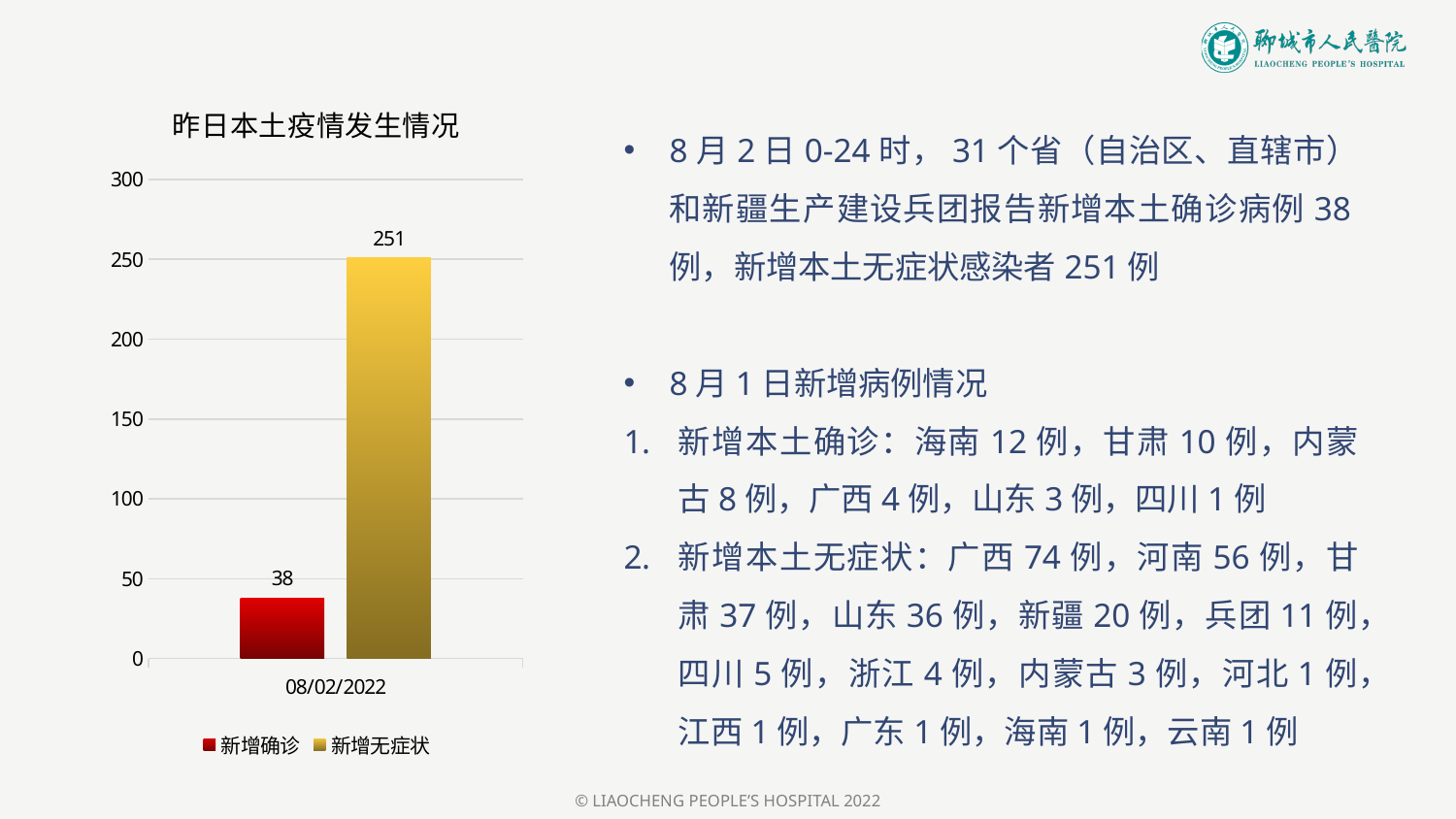
What colour is the bar for 新增确诊? red Which series has the higher value, 新增确诊 or 新增无症状? 新增无症状 What is the date label on the x axis? 08/02/2022 What kind of chart is shown on the slide? bar chart What is the title of the chart? 昨日本土疫情发生情况 What is the difference between 新增无症状 and 新增确诊 on 08/02/2022? 213 Is the value for 新增无症状 greater or less than 200? greater Is the value for 新增确诊 greater or less than 50? less What is the value of 新增无症状 on 08/02/2022? 251 What is the value of 新增确诊 on 08/02/2022? 38 How many series does the legend list? 2 How many categories are shown on the x axis? 1